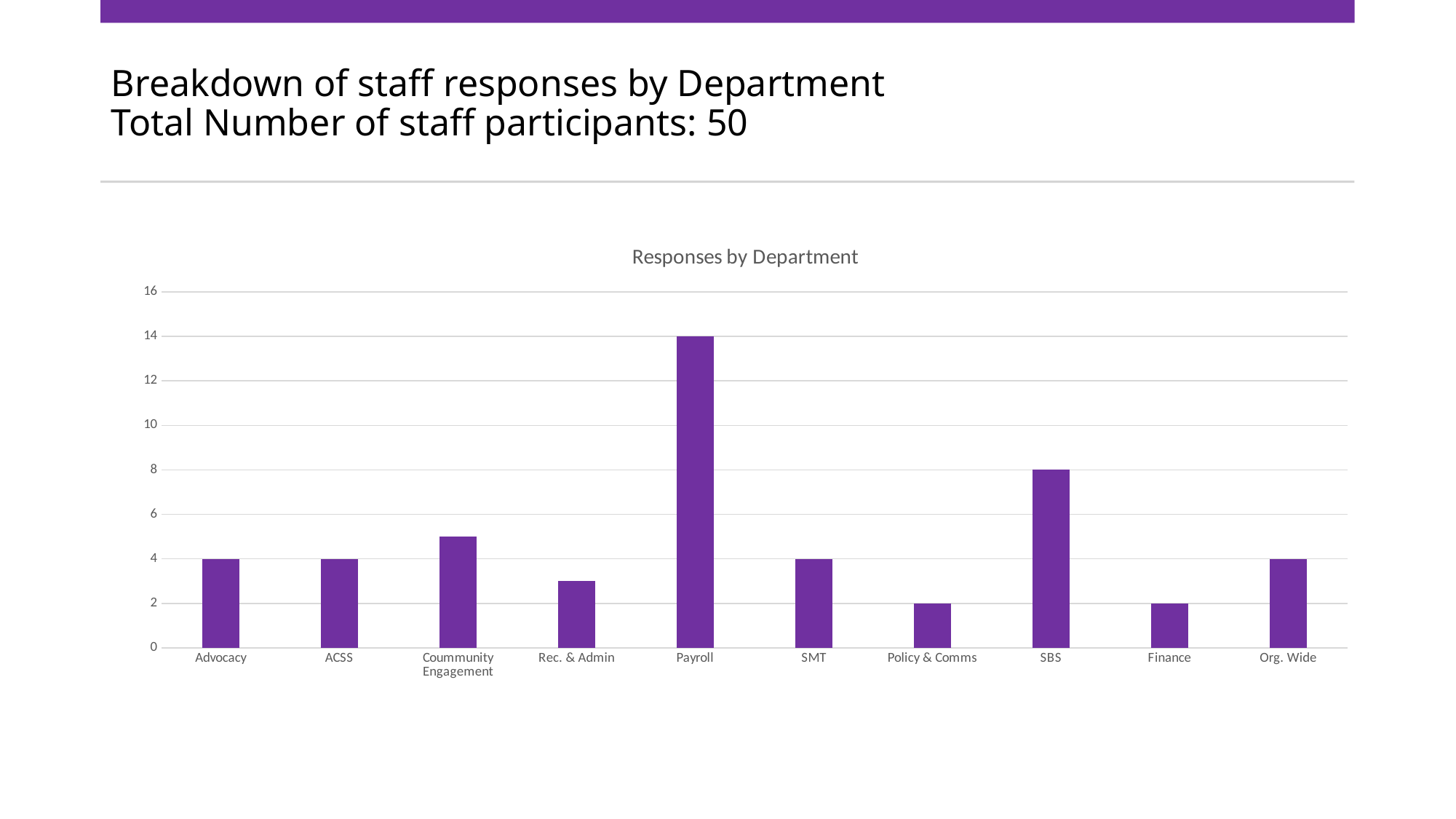
How many responses does SBS have? 8 What type of chart is shown on the slide? bar chart How many departments are shown on the x axis of the chart? 10 Is the value for Rec. & Admin greater or less than 4? less What is the difference in responses between Payroll and SBS? 6 Is the value for Coummunity Engagement greater or less than 4? greater Which department has the highest number of responses? Payroll How many responses does Finance have? 2 How many responses does Payroll have? 14 What is the title of the chart? Responses by Department How many responses does Advocacy have? 4 Which has more responses, SBS or SMT? SBS